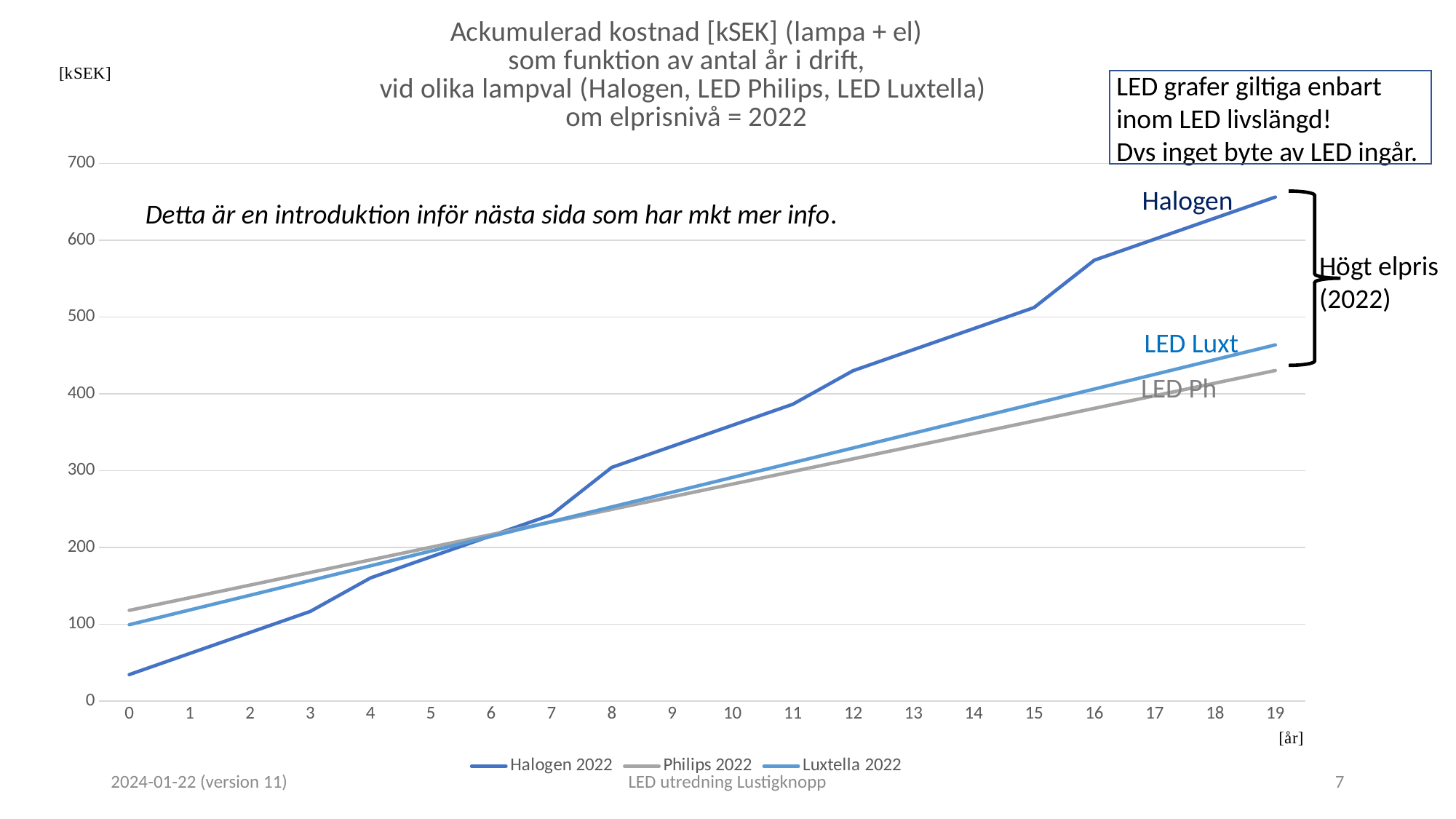
What kind of chart is shown on the slide? line chart Is the value for Halogen 2022 at year 19 greater or less than 600? greater How many series does the legend list? 3 Is the value for Halogen 2022 at year 0 greater or less than 100? less How many year values are marked along the x axis? 20 Is the value for Halogen 2022 at year 12 greater or less than 400? greater At year 0, which is larger: Philips 2022 or Halogen 2022? Philips 2022 Which series has the highest accumulated cost at year 19? Halogen 2022 Do the values for Halogen 2022 rise or fall as the number of years increases? rise At year 19, which is larger: Luxtella 2022 or Philips 2022? Luxtella 2022 Which series has the lowest accumulated cost at year 0? Halogen 2022